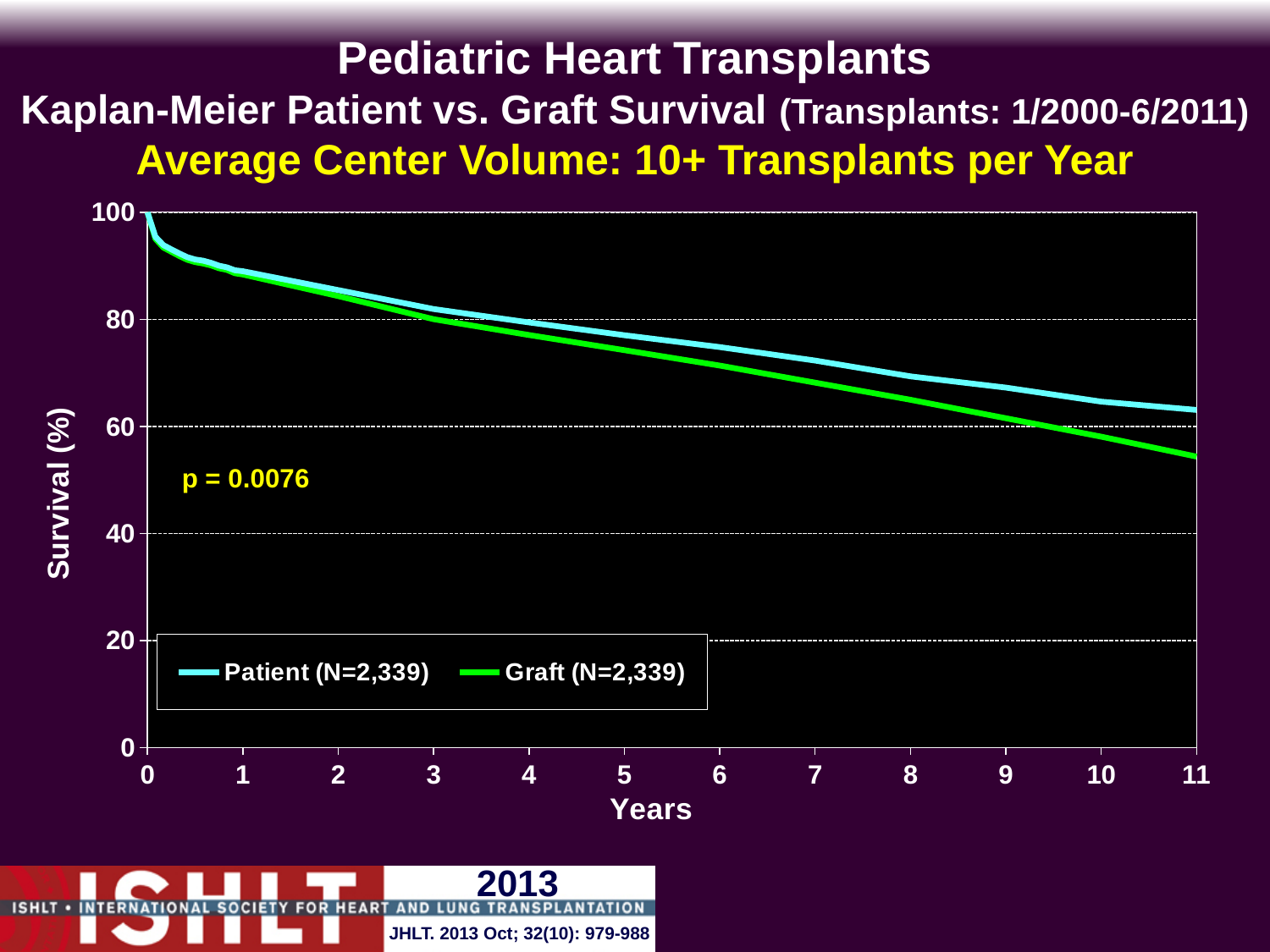
Is the Patient survival value at 11 years greater or less than 60? greater Is the Graft survival value at 11 years greater or less than 60? less Is the Patient survival value at 9 years greater or less than 60? greater At 8 years, which series has the higher survival, Patient or Graft? Patient What p-value is printed on the chart? p = 0.0076 At 11 years, which series has the lower survival, Patient or Graft? Graft Which two series are listed in the legend? Patient (N=2,339) and Graft (N=2,339) What kind of chart is shown on the slide? line chart How many series does the legend list? 2 Do the survival curves rise or fall as years increase? fall